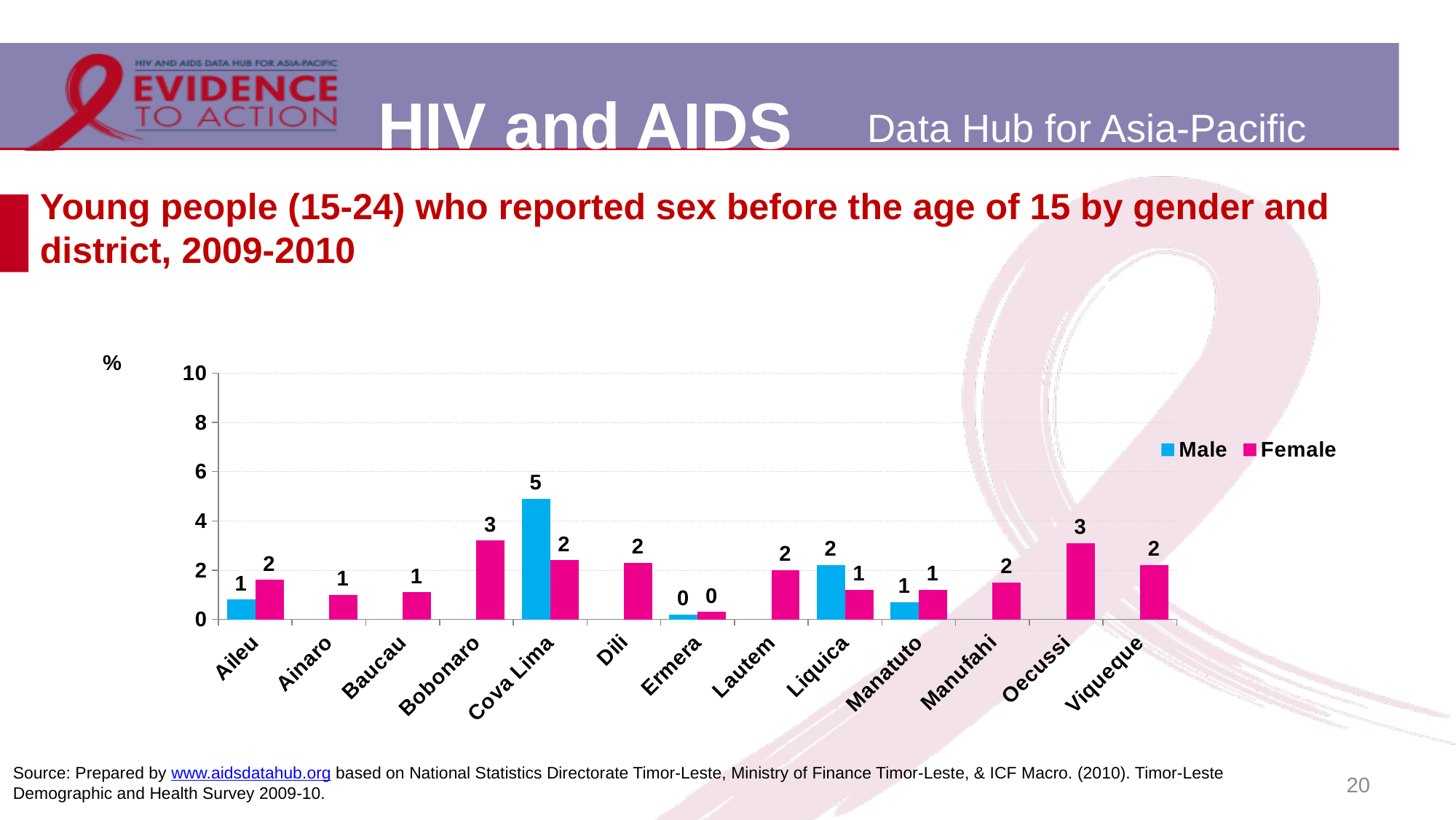
Is the Male value for Cova Lima greater or less than 4? greater What kind of chart is shown on the slide? Bar chart Which district has the highest Male value? Cova Lima How many series does the legend list? 2 In Liquica, which is larger, the Male or the Female value? Male In Aileu, which is larger, the Male or the Female value? Female What colour are the Female bars? Pink What is the Male value for Cova Lima? 5 What is the Male value for Ermera? 0 What is the Female value for Bobonaro? 3 What is the Female value for Oecussi? 3 How many districts are shown on the x axis? 13